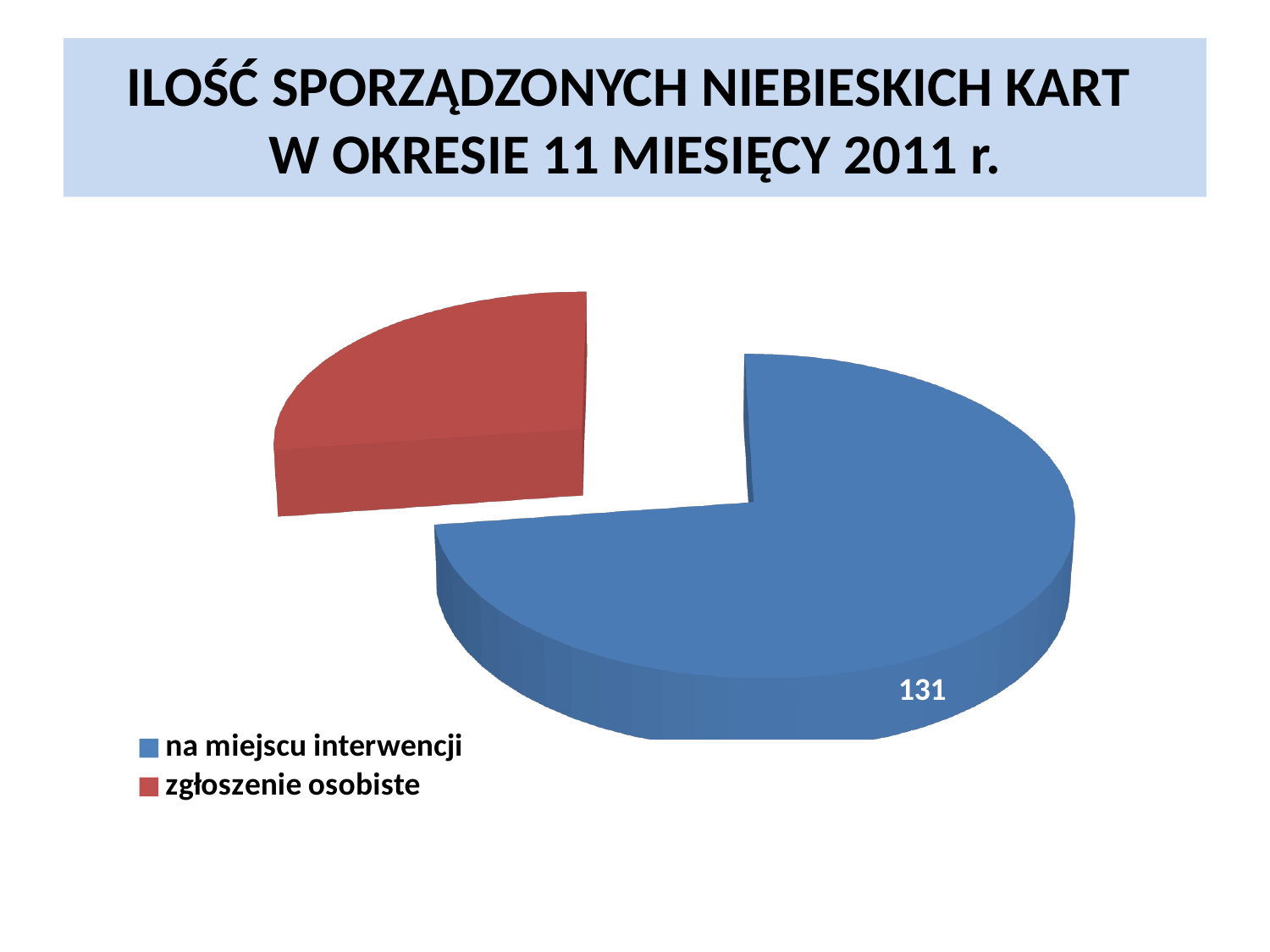
How many entries does the legend list? 2 What is the title of the slide? ILOŚĆ SPORZĄDZONYCH NIEBIESKICH KART W OKRESIE 11 MIESIĘCY 2011 r. What value is shown for the "na miejscu interwencji" slice? 131 Which category has the smallest slice of the pie? zgłoszenie osobiste How many slices does the pie chart have? 2 Which category has the largest slice of the pie? na miejscu interwencji What kind of chart is shown on the slide? Pie chart Which is larger, the slice for "na miejscu interwencji" or the slice for "zgłoszenie osobiste"? na miejscu interwencji What colour is the slice for "zgłoszenie osobiste"? Red